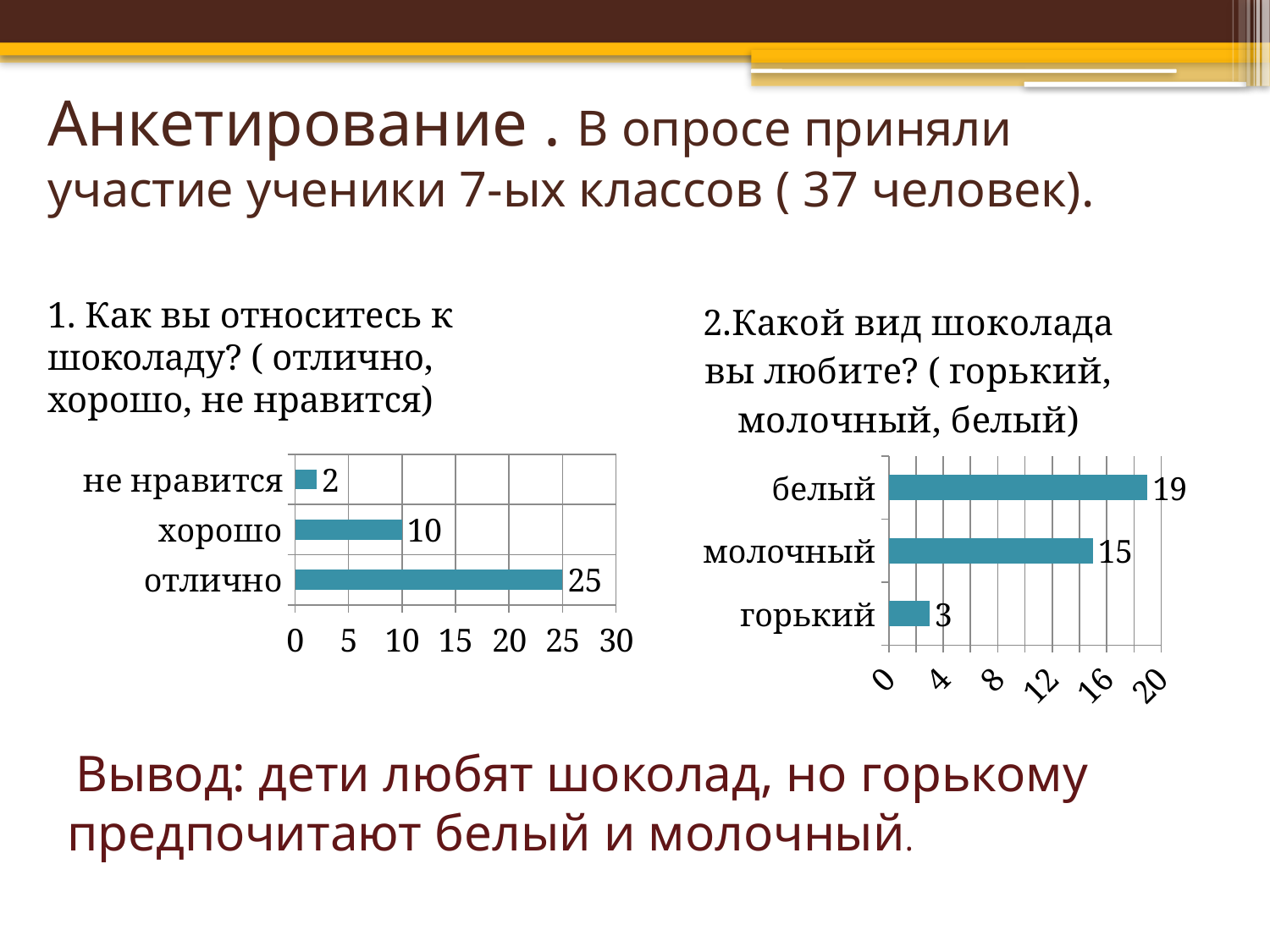
In the left chart (question 1, attitude to chocolate), is the value for "отлично" greater or less than 20? greater In the right chart (question 2, type of chocolate), which category has the highest value? белый In the right chart (question 2, type of chocolate), what is the value for "молочный"? 15 In the left chart (question 1, attitude to chocolate), what is the difference between "отлично" and "хорошо"? 15 In the left chart (question 1, attitude to chocolate), which category has the lowest value? не нравится In the left chart (question 1, attitude to chocolate), how many categories are shown? 3 What kind of chart is the right chart (question 2, type of chocolate)? bar chart In the right chart (question 2, type of chocolate), what is the value for "горький"? 3 In the right chart (question 2, type of chocolate), what is the difference between "белый" and "горький"? 16 In the right chart (question 2, type of chocolate), which is larger, "белый" or "молочный"? белый In the left chart (question 1, attitude to chocolate), what is the value for "отлично"? 25 In the left chart (question 1, attitude to chocolate), what is the value for "хорошо"? 10